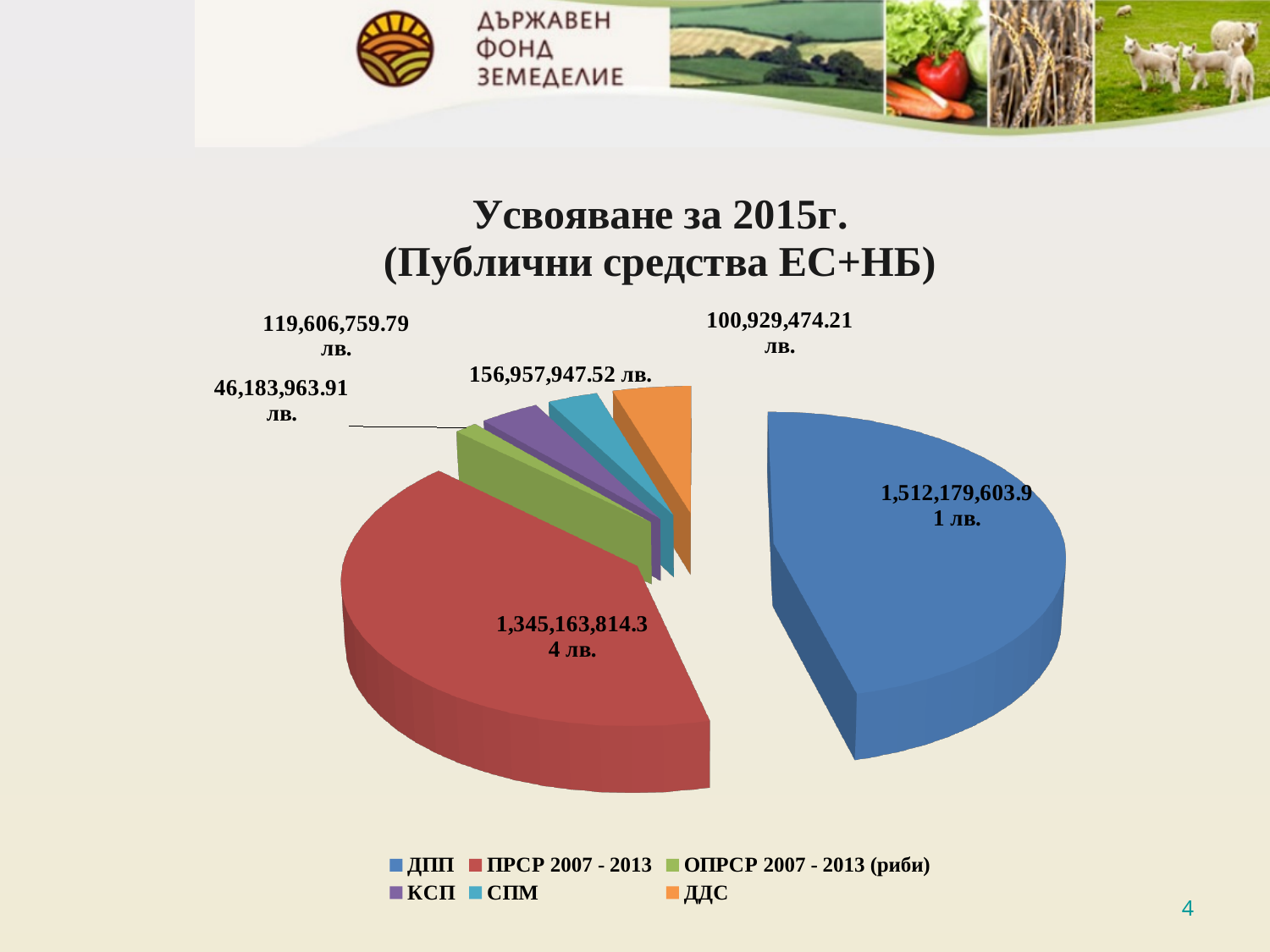
What is the value for ДПП? 1,512,179,603.91 лв. What is the value for ПРСР 2007 - 2013? 1,345,163,814.34 лв. Which category has the largest slice of the pie? ДПП What is the smallest value labelled on the pie chart? 46,183,963.91 лв. What is the title of the chart? Усвояване за 2015г. (Публични средства ЕС+НБ) How many categories does the legend of the pie chart list? 6 Which is larger, ДДС or ПРСР 2007 - 2013? ПРСР 2007 - 2013 What is the value for ДДС? 156,957,947.52 лв. Which colour represents ДПП in the legend? Blue Which is larger, ДПП or ПРСР 2007 - 2013? ДПП What is the difference between the values for ДПП and ПРСР 2007 - 2013? 167,015,789.57 лв. What type of chart is shown on the slide? Pie chart